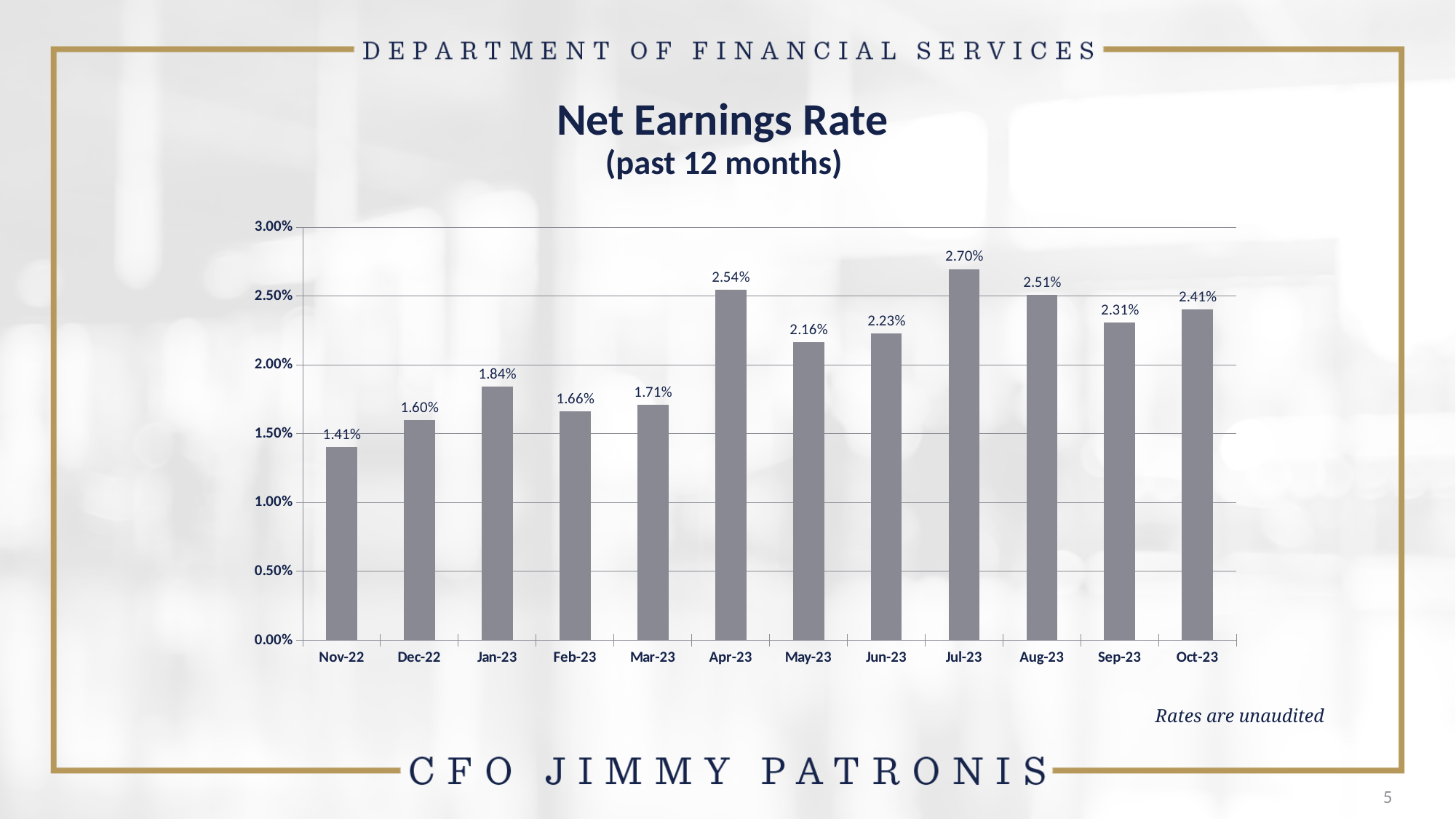
Which month has the lowest net earnings rate? Nov-22 What is the net earnings rate for Nov-22? 1.41% Is the net earnings rate for Mar-23 greater or less than 2.00%? less Which month has a higher net earnings rate, Apr-23 or May-23? Apr-23 What kind of chart is shown on the slide? bar chart What is the title of the chart? Net Earnings Rate (past 12 months) What is the net earnings rate for Apr-23? 2.54% What is the difference between the net earnings rate in Jul-23 and Nov-22? 1.29% How many months are shown on the chart? 12 Which month has the highest net earnings rate? Jul-23 What is the difference between the net earnings rate in Oct-23 and Sep-23? 0.10% What is the net earnings rate for Jul-23? 2.70%